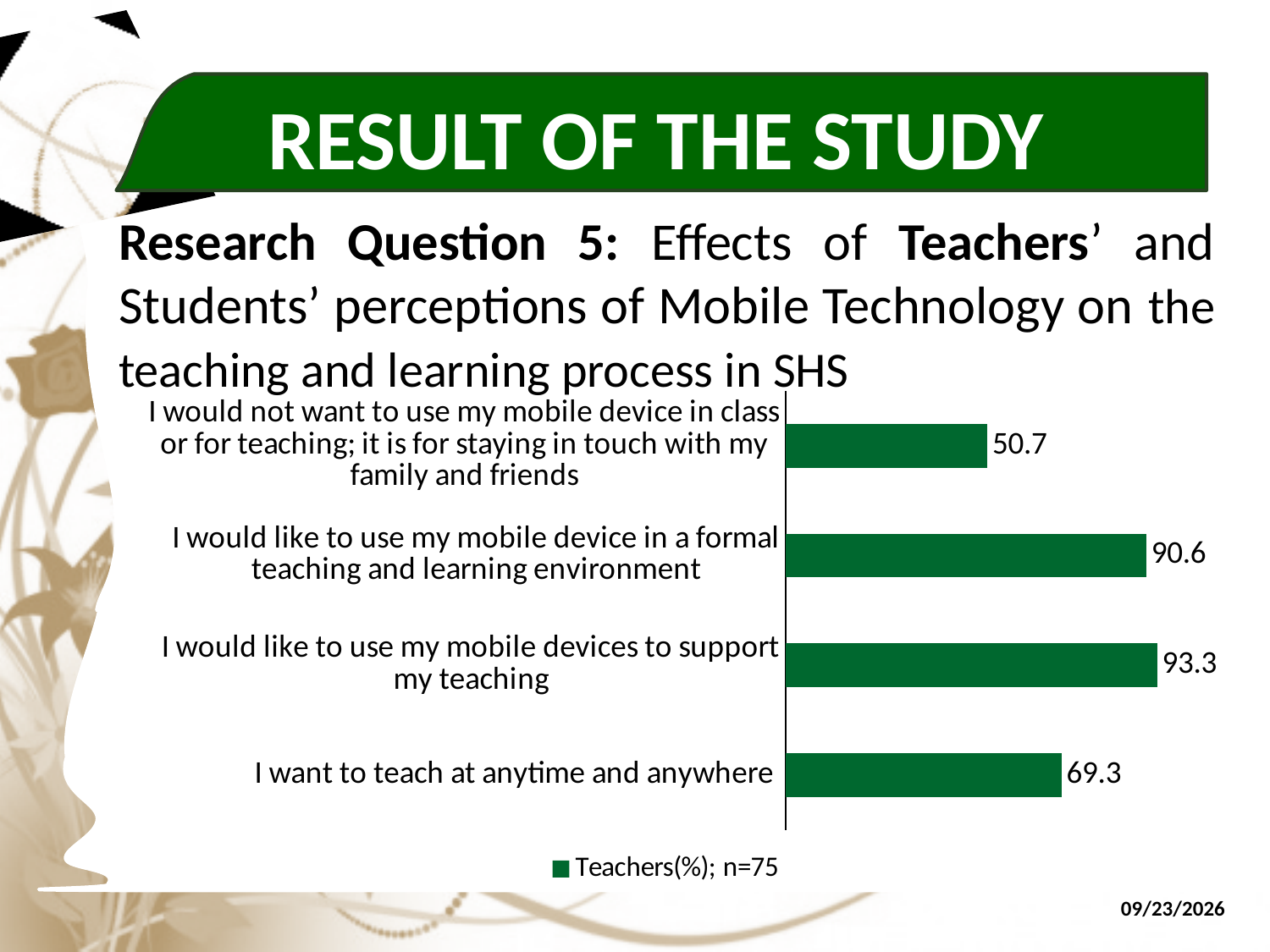
Which is larger: the value for "I want to teach at anytime and anywhere" or the value for "I would not want to use my mobile device in class or for teaching; it is for staying in touch with my family and friends"? I want to teach at anytime and anywhere How many series does the legend list? 1 What is the difference between the values for "I would like to use my mobile devices to support my teaching" and "I want to teach at anytime and anywhere"? 24 What is the value for "I would like to use my mobile device in a formal teaching and learning environment"? 90.6 What is the value for "I would not want to use my mobile device in class or for teaching; it is for staying in touch with my family and friends"? 50.7 What kind of chart is shown on the slide? Bar chart What is the value for "I would like to use my mobile devices to support my teaching"? 93.3 What is the value for "I want to teach at anytime and anywhere"? 69.3 What is the difference between the values for "I would like to use my mobile device in a formal teaching and learning environment" and "I would not want to use my mobile device in class or for teaching; it is for staying in touch with my family and friends"? 39.9 Which category has the lowest value? I would not want to use my mobile device in class or for teaching; it is for staying in touch with my family and friends Which category has the highest value? I would like to use my mobile devices to support my teaching How many categories are shown in the chart? 4